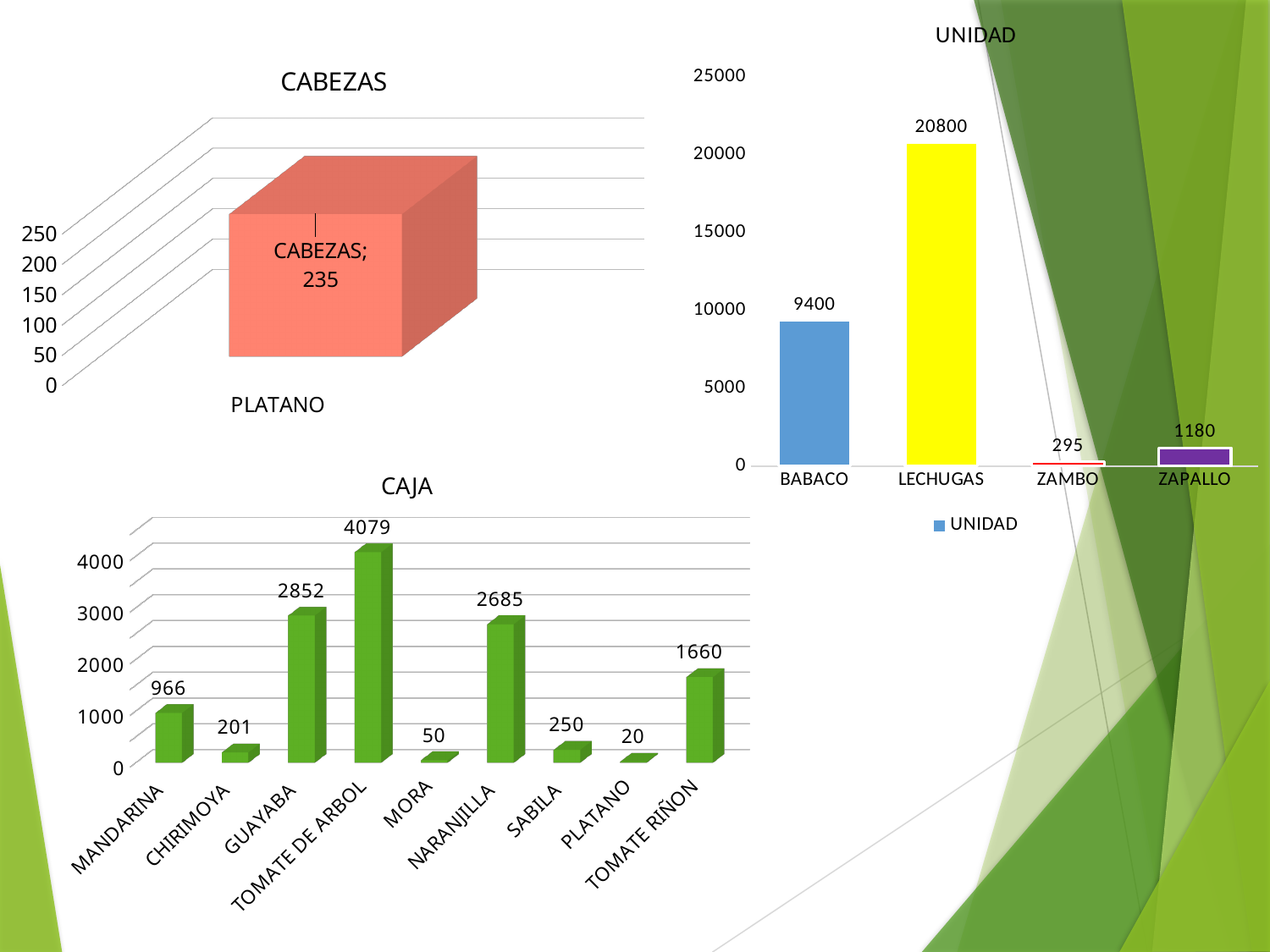
In the CAJA chart, what is the value for NARANJILLA? 2685 In the CAJA chart, how many categories are shown? 9 What kind of chart is the CAJA chart? bar chart In the CABEZAS chart, what is the value for PLATANO? 235 In the CAJA chart, what is the difference between GUAYABA and MANDARINA? 1886 In the CAJA chart, which is larger, SABILA or CHIRIMOYA? SABILA In the UNIDAD chart, what is the value for LECHUGAS? 20800 In the UNIDAD chart, how many categories are shown? 4 In the CAJA chart, which category has the highest value? TOMATE DE ARBOL In the UNIDAD chart, what is the difference between BABACO and ZAPALLO? 8220 In the UNIDAD chart, which category has the lowest value? ZAMBO In the CAJA chart, which category has the lowest value? PLATANO